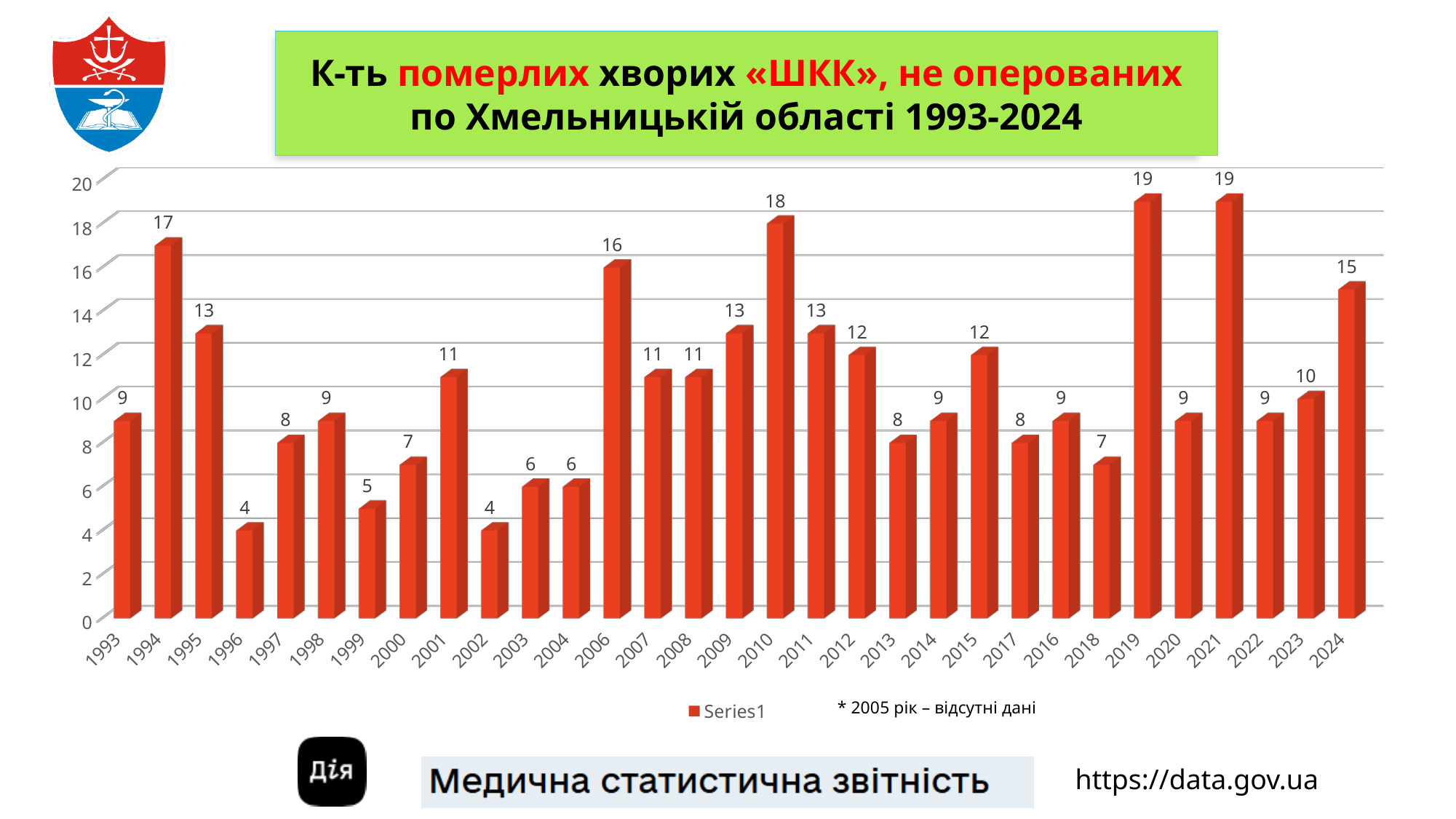
What is the value for 2010? 18 What kind of chart is shown on the slide? Bar chart Which two years share the lowest value on the chart? 1996 and 2002 What is the value for 2024? 15 How many bars (years) are plotted on the chart? 31 How many series does the legend list? 1 Which is larger, the value for 2015 or the value for 2013? 2015 Which two years share the highest value on the chart? 2019 and 2021 What is the value for 1994? 17 What is the highest value shown on the chart? 19 What is the value for 1999? 5 What is the difference between the values for 2006 and 2007? 5